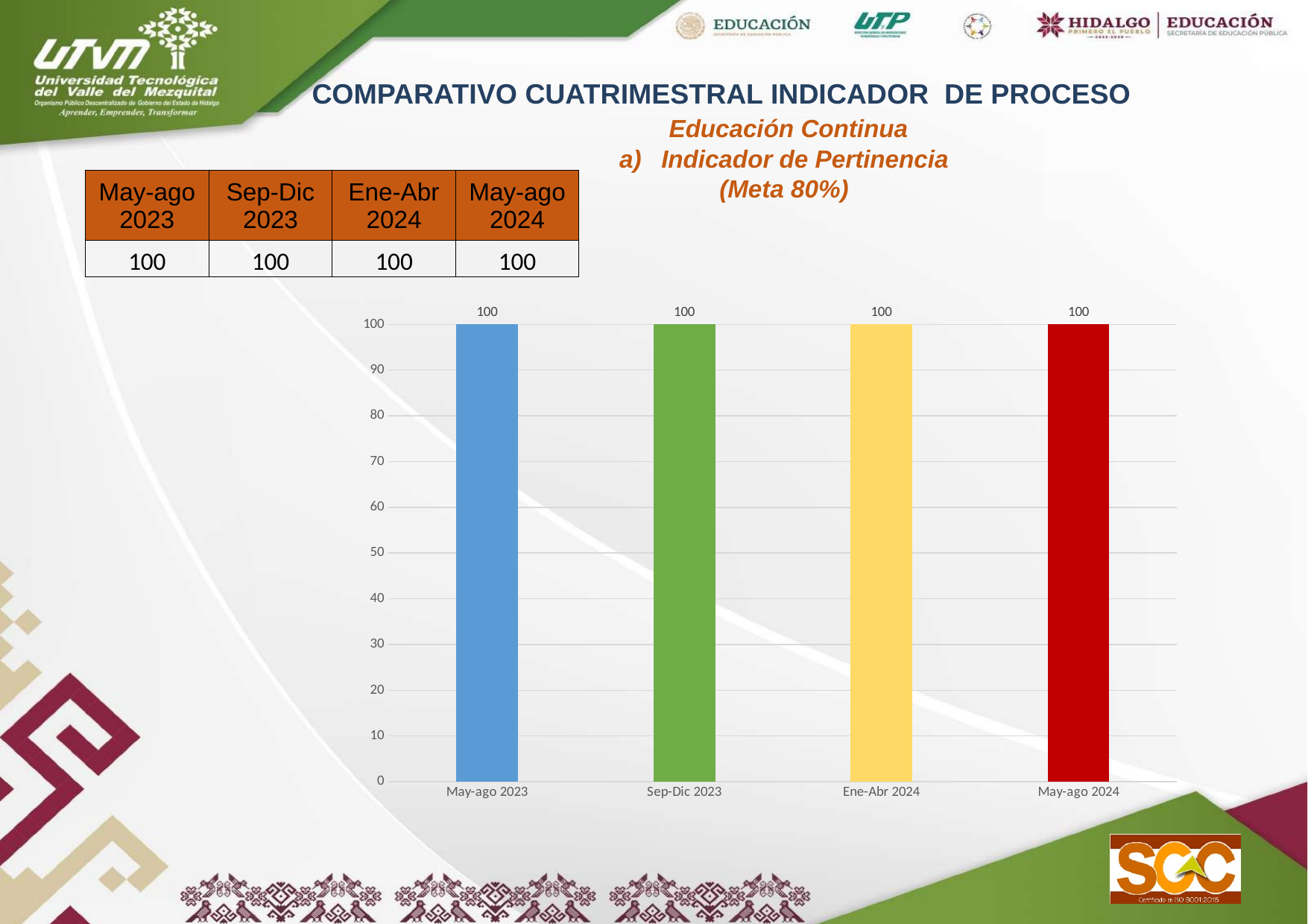
What is the value for May-ago 2024 in the chart? 100 What colour is the bar for May-ago 2024? red Is the value for Ene-Abr 2024 greater or less than 80? greater Do the values rise, fall, or stay the same from May-ago 2023 to May-ago 2024? stay the same What kind of chart is shown on the slide? bar chart How many categories (periods) are shown on the x axis of the chart? 4 What is the value for Sep-Dic 2023 in the chart? 100 What is the difference between the values for May-ago 2024 and May-ago 2023? 0 What is the label of the first category on the x axis of the chart? May-ago 2023 What is the value for Ene-Abr 2024 in the chart? 100 What is the value for May-ago 2023 in the chart? 100